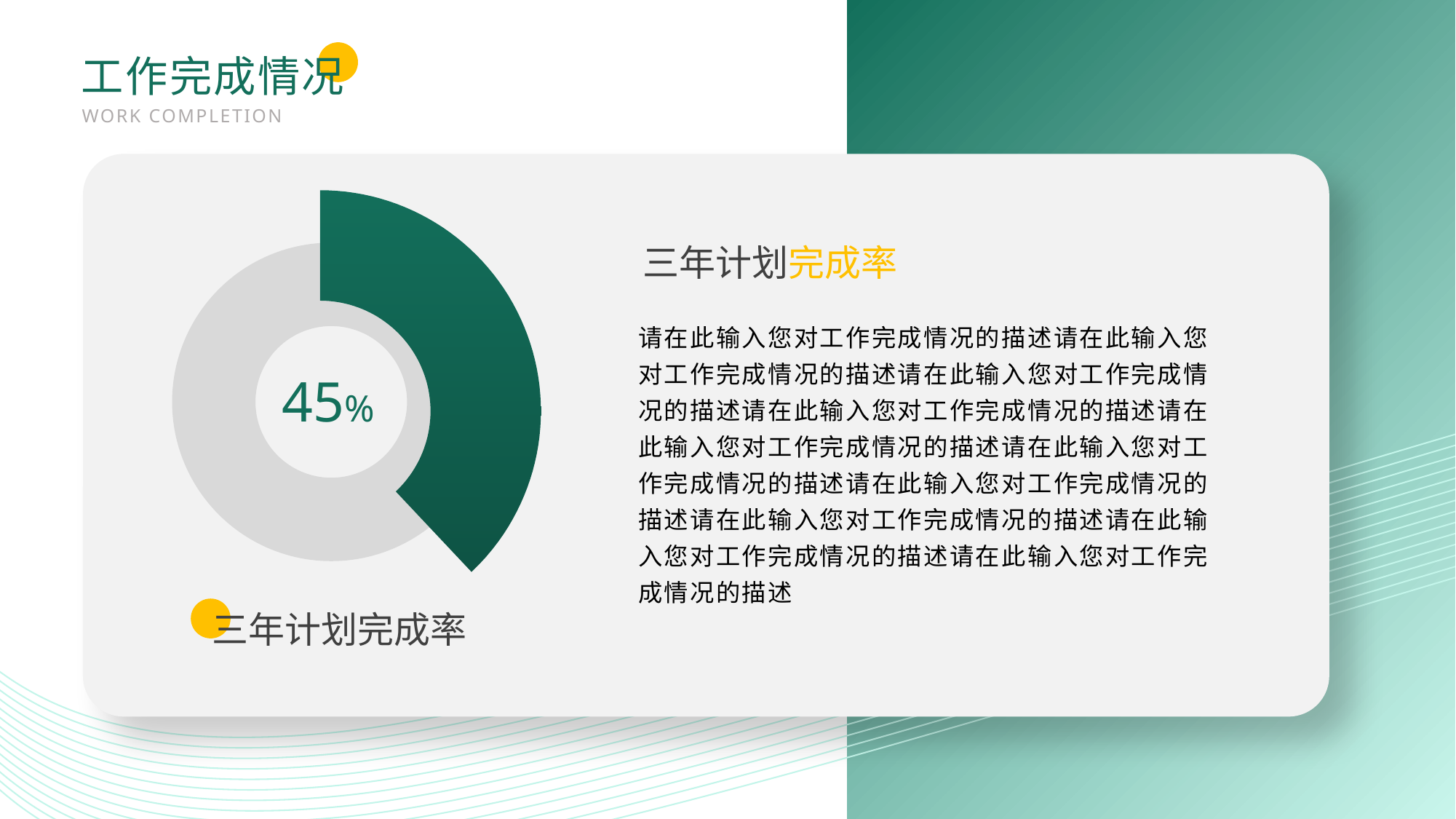
What kind of chart is shown on the slide? Donut (pie) chart What colour is the segment representing the completed portion of the donut chart? Green What value is printed in the centre of the donut chart? 45% What is the 三年计划完成率 shown by the chart? 45% What is the label printed below the donut chart? 三年计划完成率 Is the completion rate shown in the chart greater or less than 50%? less How many segments does the donut chart have? 2